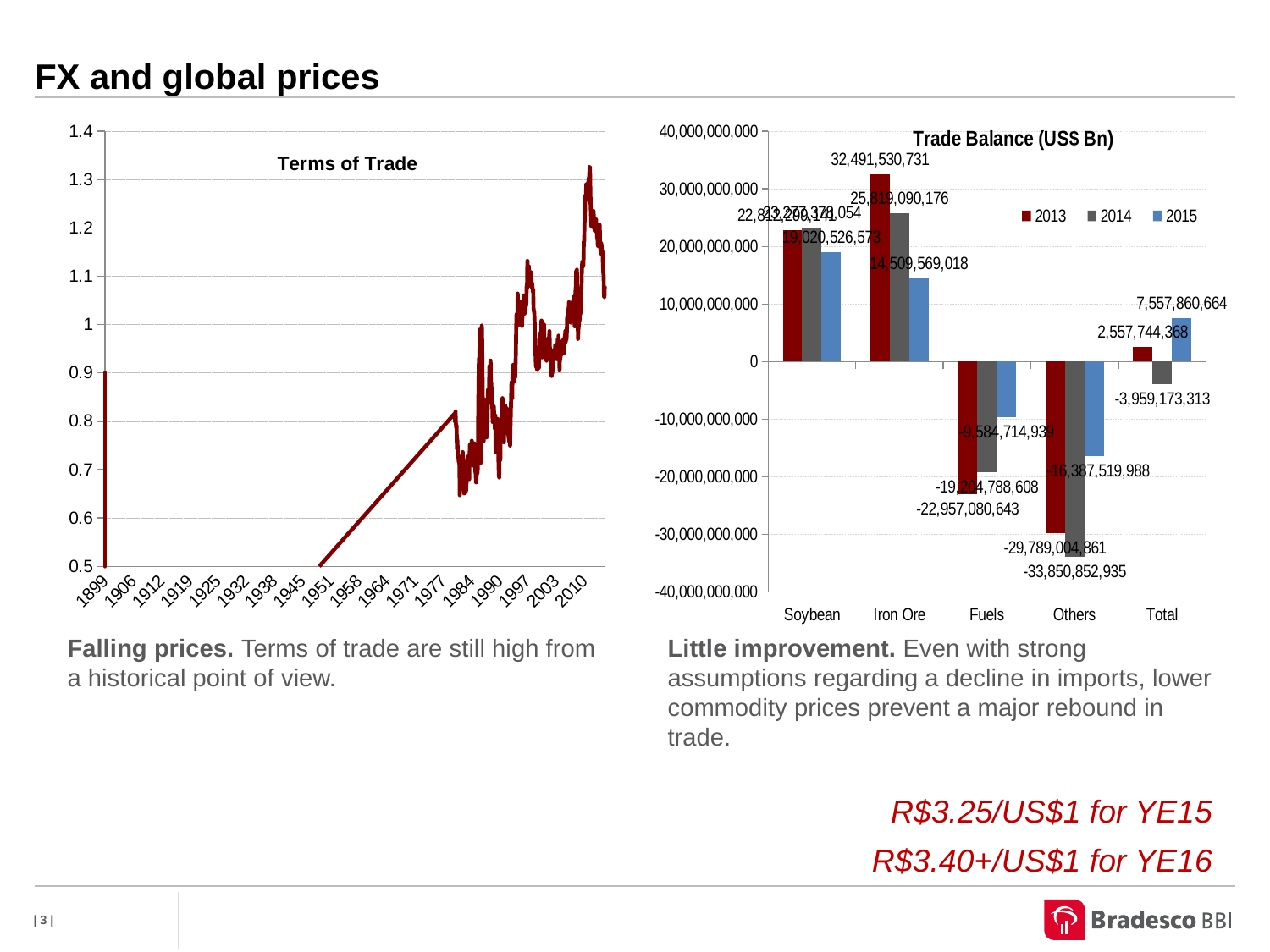
In the Trade Balance (US$ Bn) chart, what is the 2015 value for Total? 7,557,860,664 What kind of chart is the Trade Balance (US$ Bn) chart? bar chart In the Trade Balance (US$ Bn) chart, which category has the highest 2013 value? Iron Ore In the Trade Balance (US$ Bn) chart, what is the 2013 value for Iron Ore? 32,491,530,731 How many series does the legend of the Trade Balance (US$ Bn) chart list? 3 What kind of chart is the Terms of Trade chart? line chart How many categories are shown on the x axis of the Trade Balance (US$ Bn) chart? 5 In the Trade Balance (US$ Bn) chart, what is the 2014 value for Others? -33,850,852,935 In the Trade Balance (US$ Bn) chart, which category has the lowest 2014 value? Others In the Trade Balance (US$ Bn) chart, what is the 2013 value for Fuels? -22,957,080,643 In the Terms of Trade chart, is the peak value of the line greater or less than 1.2? greater In the Trade Balance (US$ Bn) chart, what is the difference between the 2015 and 2013 values for Total? 5,000,116,296